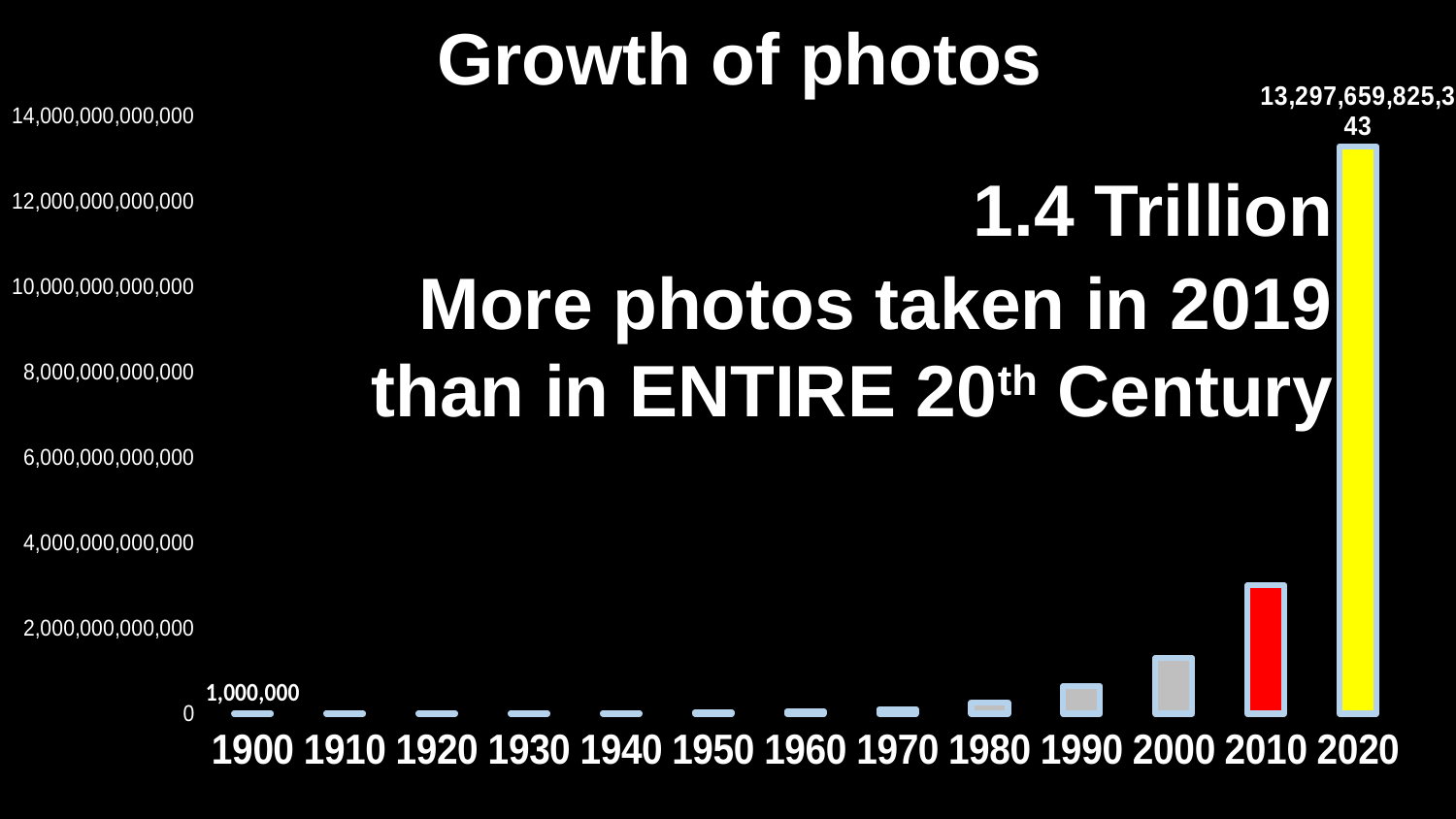
Is the value for 2000 greater or less than 2,000,000,000,000? less What is the value shown for 1900 in the chart? 1,000,000 What colour is the bar for 2020 in the chart? yellow What is the value shown for 2020 in the chart? 13,297,659,825,343 Is the value for 2010 greater or less than 2,000,000,000,000? greater Is the value for 2010 greater or less than 4,000,000,000,000? less Which year has the highest value in the chart? 2020 Which is larger, the value for 2010 or the value for 2000? 2010 Do the values generally rise or fall from 1900 to 2020 along the x axis? rise What kind of chart is shown on the slide? bar chart What is the title of the chart? Growth of photos How many years (categories) are shown on the x axis of the chart? 13